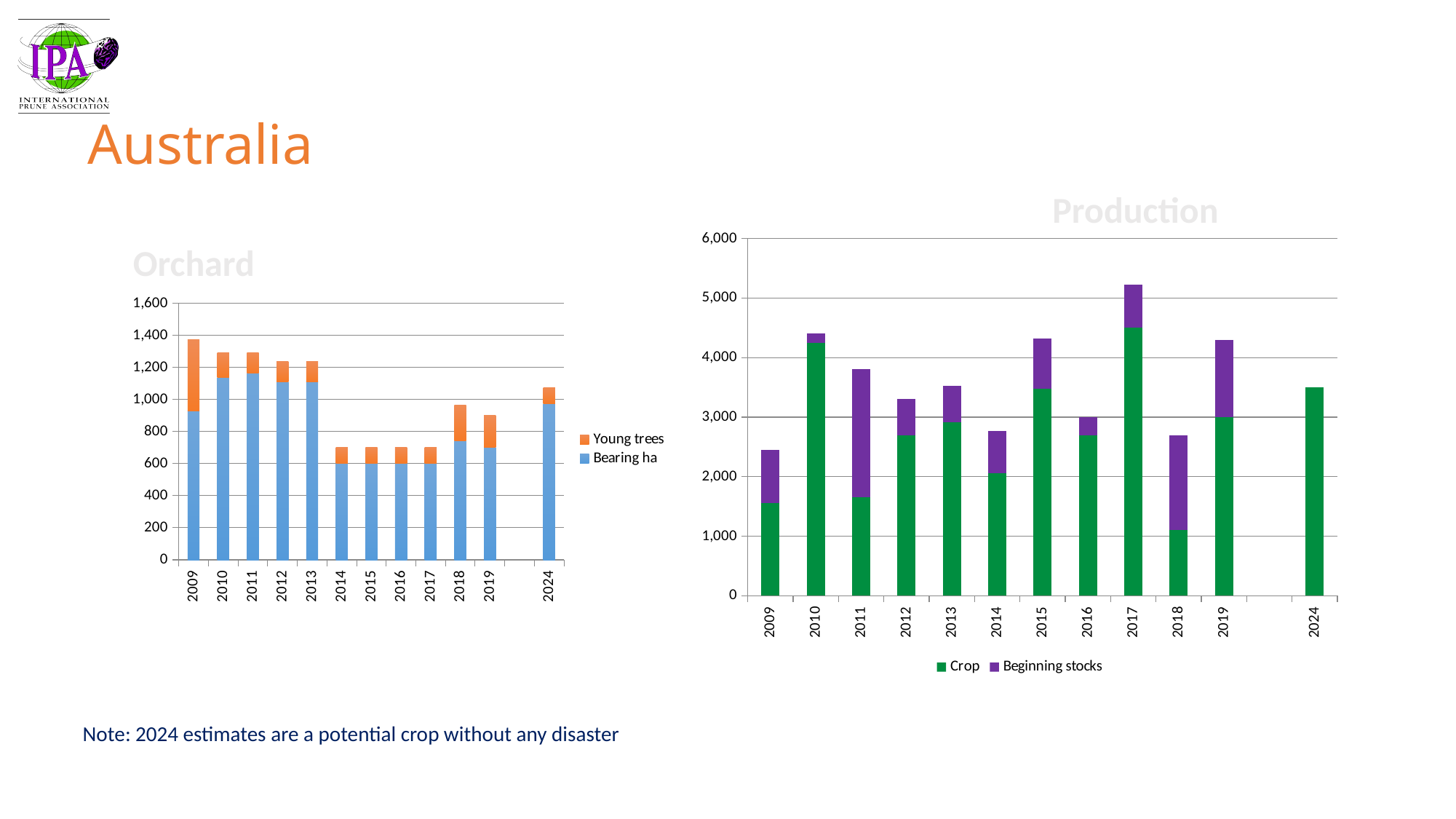
In the Production chart, is the total bar for 2017 greater or less than 5,000? greater In the Production chart, is the Crop value for 2024 greater or less than 3,000? greater How many series does the legend of the Production chart list? 2 In the Production chart, which year has the lowest Crop value? 2018 In the Orchard chart, which year has the highest total bar? 2009 In the Orchard chart, is the total bar for 2014 greater or less than 800? less In the Production chart, which year has the larger total bar, 2011 or 2012? 2011 What type of chart is the Orchard chart? Stacked bar chart What are the two series shown in the Orchard chart's legend? Young trees and Bearing ha In the Orchard chart, which year has the larger total bar, 2018 or 2014? 2018 In the Production chart, which year has the highest total bar? 2017 How many years are shown on the x axis of the Production chart? 12